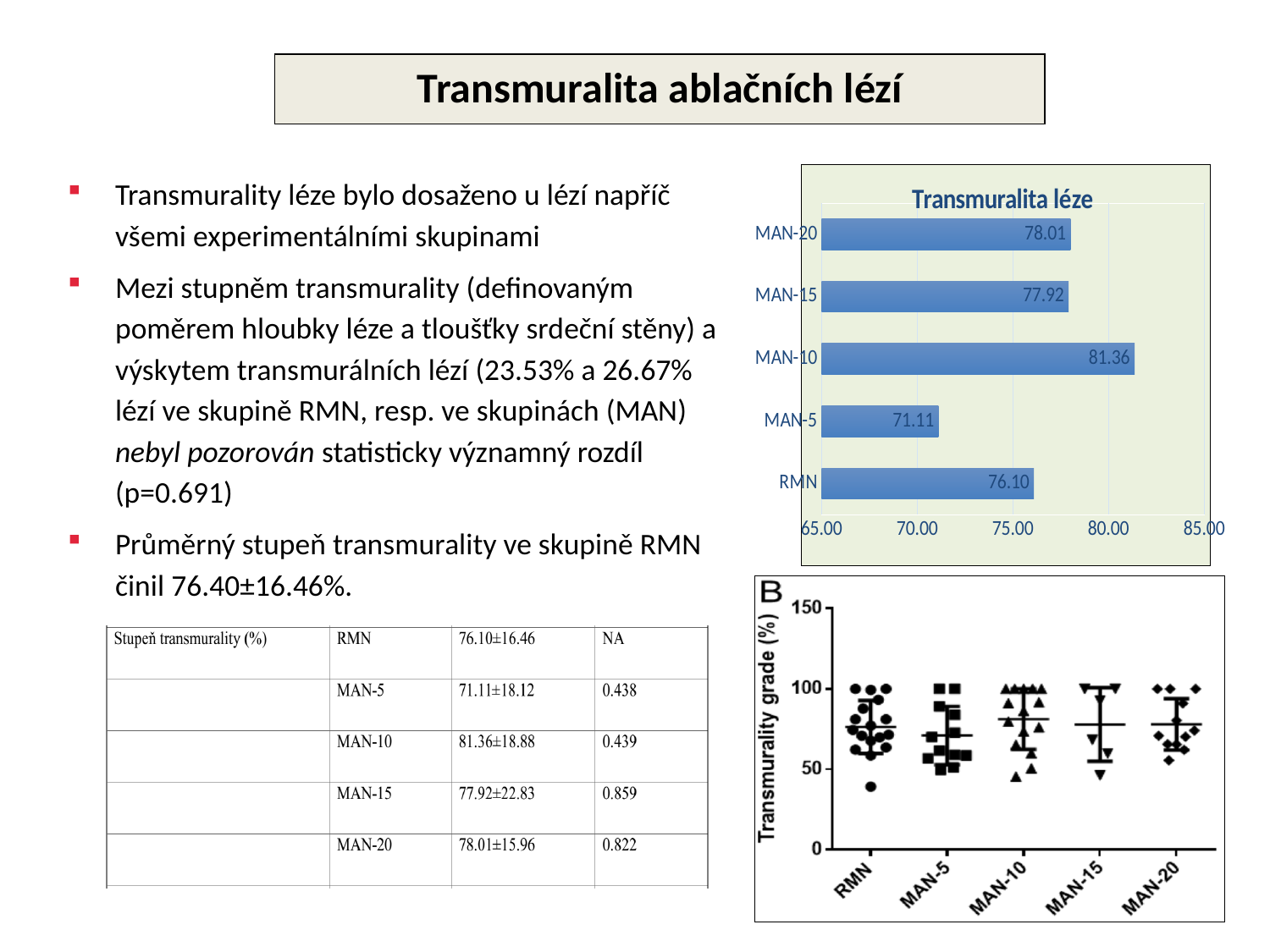
In the bar chart titled 'Transmuralita léze', which group has the lowest value? MAN-5 How many groups are shown in the bar chart titled 'Transmuralita léze'? 5 In the bar chart titled 'Transmuralita léze', which has the larger value, MAN-20 or MAN-15? MAN-20 In the bar chart titled 'Transmuralita léze', what is the value for MAN-10? 81.36 What is the title of the chart in the top right of the slide? Transmuralita léze In the bar chart titled 'Transmuralita léze', is the value for MAN-5 greater or less than 75.00? less In the bar chart titled 'Transmuralita léze', what is the difference between the values for MAN-20 and RMN? 1.91 What kind of chart is the chart titled 'Transmuralita léze'? bar chart In the bar chart titled 'Transmuralita léze', which group has the highest value? MAN-10 In the bar chart titled 'Transmuralita léze', what is the difference between the values for MAN-10 and MAN-5? 10.25 In the bar chart titled 'Transmuralita léze', what is the value for RMN? 76.10 How many groups are shown on the x axis of the chart labelled 'B' in the bottom right of the slide? 5